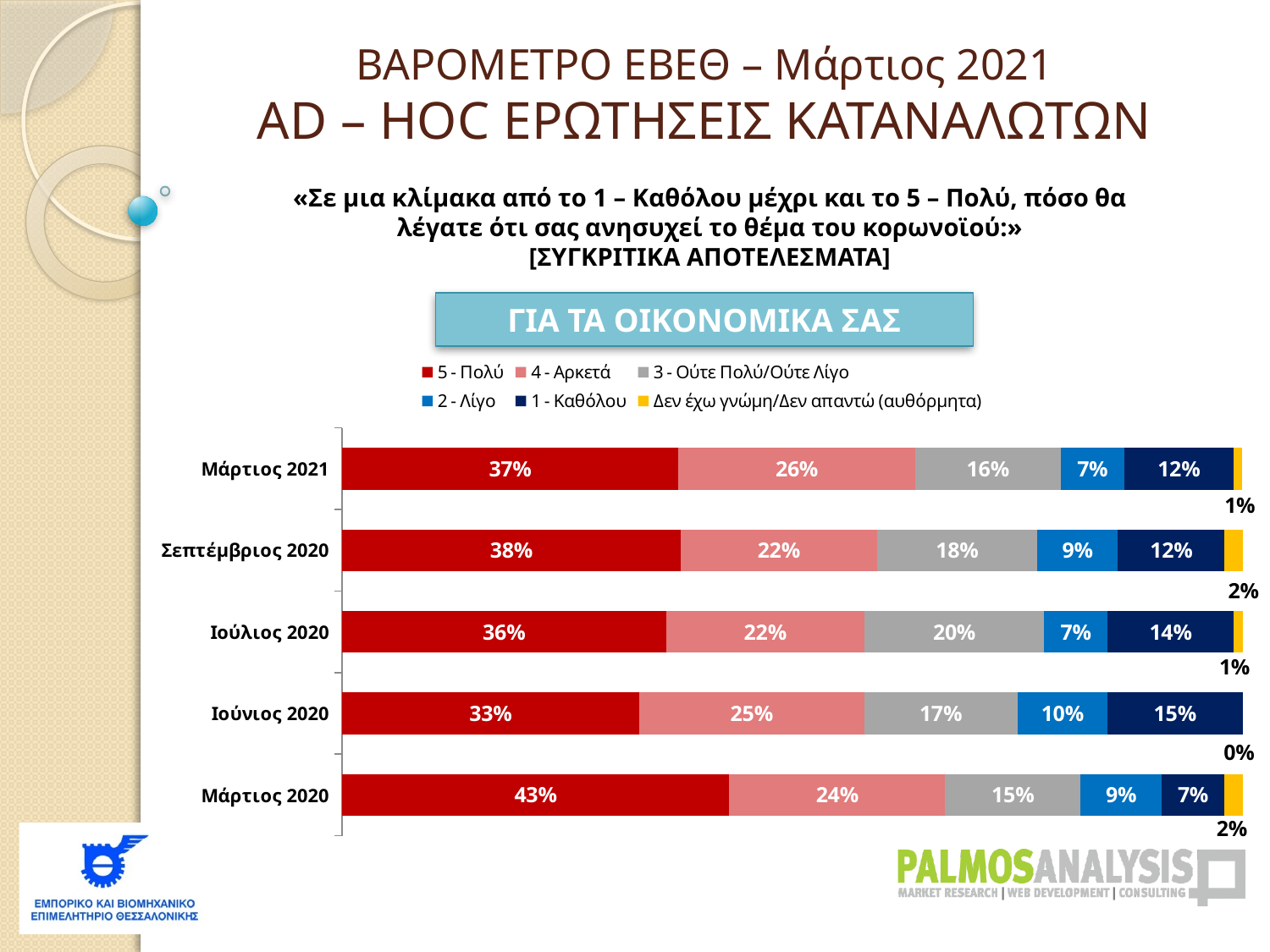
How many series does the legend list? 6 What is the difference between the '5 - Πολύ' values for Μάρτιος 2020 and Μάρτιος 2021? 6% Which is larger: the '4 - Αρκετά' value for Μάρτιος 2021 or for Ιούνιος 2020? Μάρτιος 2021 What is the value for 'Δεν έχω γνώμη/Δεν απαντώ (αυθόρμητα)' in Σεπτέμβριος 2020? 2% Which period has the lowest value for '1 - Καθόλου'? Μάρτιος 2020 What is the value for '3 - Ούτε Πολύ/Ούτε Λίγο' in Ιούλιος 2020? 20% Which period has the highest value for '5 - Πολύ'? Μάρτιος 2020 What is the title shown in the box above the chart? ΓΙΑ ΤΑ ΟΙΚΟΝΟΜΙΚΑ ΣΑΣ What type of chart is shown on the slide? Stacked bar chart What is the value for '5 - Πολύ' in Μάρτιος 2021? 37% What is the value for '1 - Καθόλου' in Ιούνιος 2020? 15% How many time periods (categories) are shown in the chart? 5